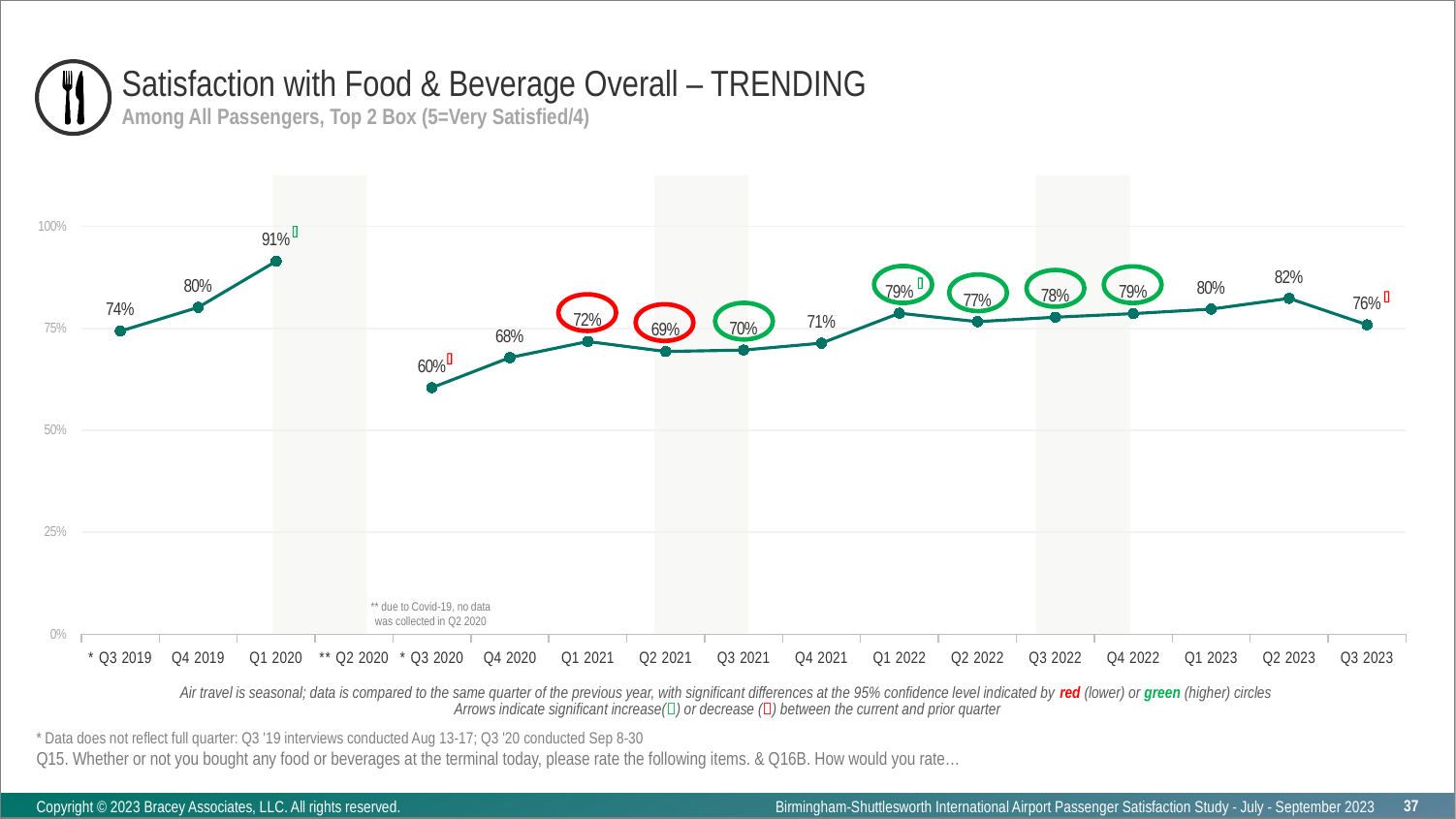
Is the value for Q3 2020 greater or less than 75%? less What is the value for Q2 2022? 77% What is the difference between the values for Q2 2023 and Q3 2023? 6 percentage points Which quarter has the lowest value? Q3 2020 What is the value for Q3 2023? 76% Which quarter has the highest value? Q1 2020 Do the values rise or fall from Q3 2020 to Q1 2021? rise What kind of chart is shown on the slide? line chart For which quarter on the x axis was no data collected? Q2 2020 Which is larger, the value for Q4 2019 or the value for Q4 2020? Q4 2019 What is the value for Q1 2020? 91% What is the difference between the values for Q1 2020 and Q3 2020? 31 percentage points